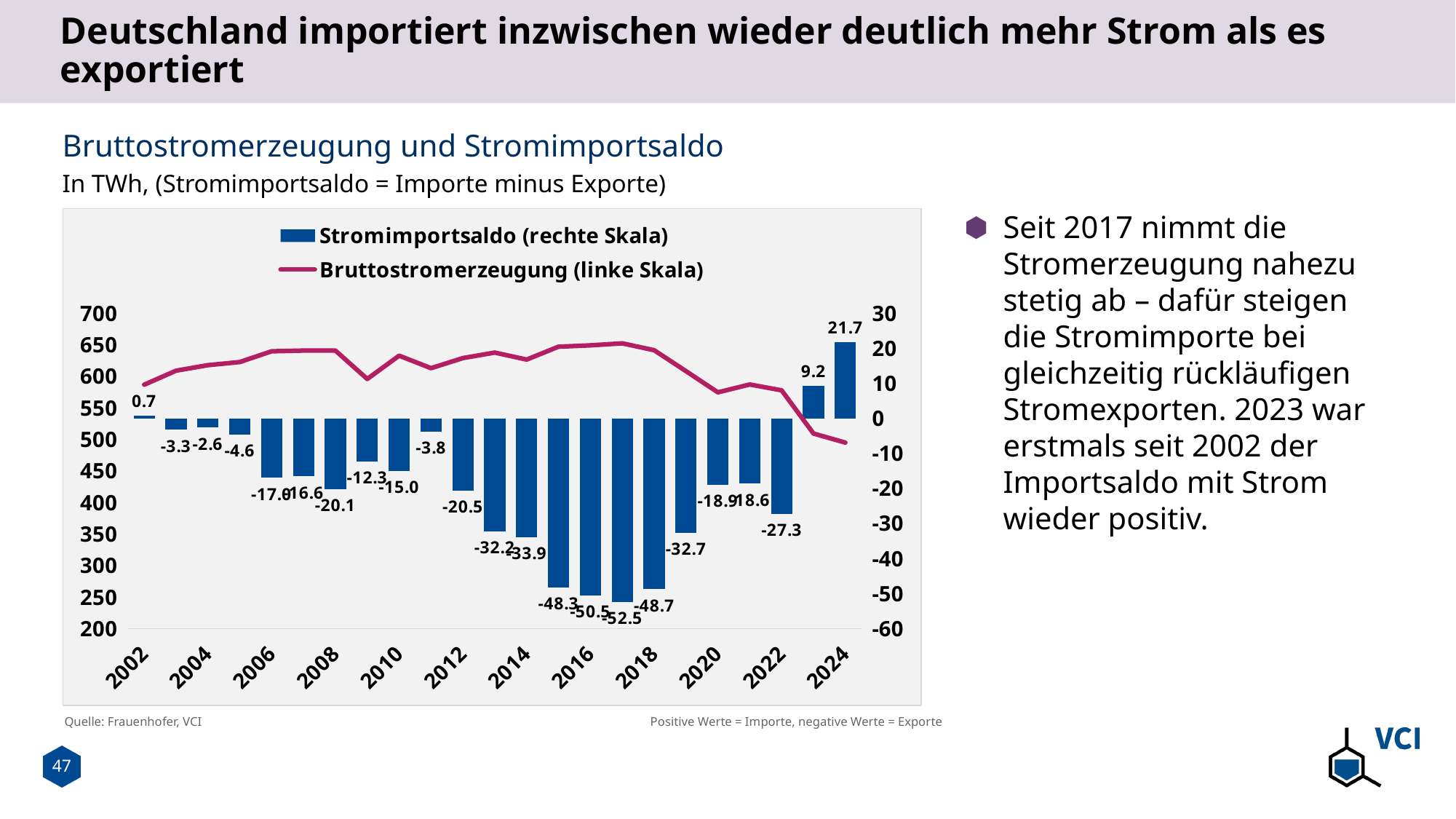
What is the Stromimportsaldo value for 2002? 0.7 Is the Bruttostromerzeugung value for 2024 greater or less than 550? less Is the Bruttostromerzeugung value for 2002 greater or less than 550? greater Which year has the larger Stromimportsaldo, 2006 or 2010? 2010 By how much did the Stromimportsaldo increase from 2023 to 2024? 12.5 Does the Bruttostromerzeugung line rise or fall from 2017 to 2024? Fall In which year is the Stromimportsaldo highest? 2024 What kind of chart is shown on the slide? Combination bar and line chart In which year is the Stromimportsaldo lowest? 2017 What is the Stromimportsaldo value for 2024? 21.7 How many series does the legend list? 2 What is the Stromimportsaldo value for 2017? -52.5